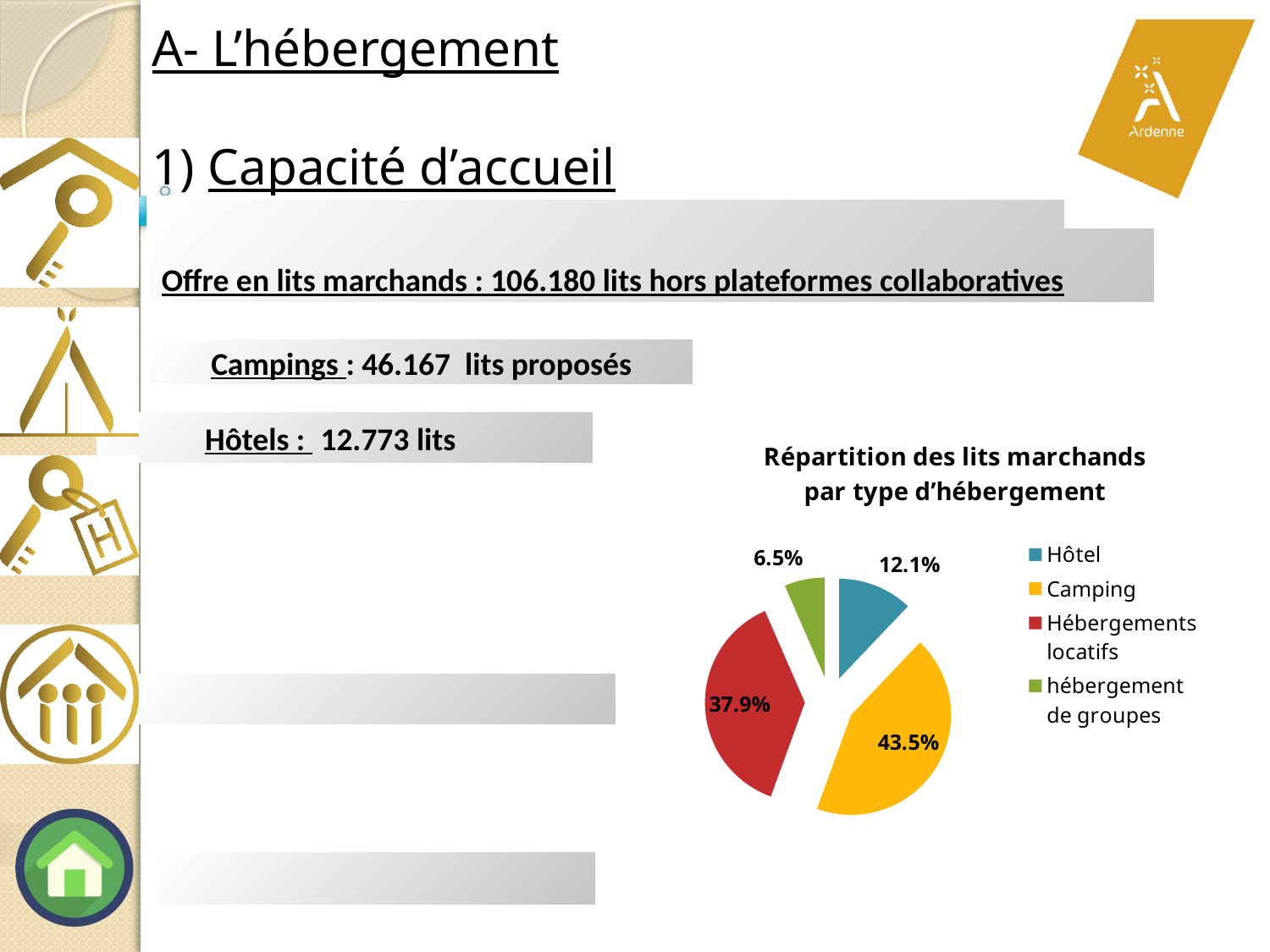
What is the title of the chart? Répartition des lits marchands par type d'hébergement What share of the pie does Hôtel represent? 12.1% What colour is the Hébergements locatifs slice? red What share of the pie does hébergement de groupes represent? 6.5% Which category has the smallest slice of the pie? hébergement de groupes How many categories does the legend list? 4 What share of the pie does Camping represent? 43.5% What type of chart is shown on the slide? pie chart What is the difference in percentage points between Camping and Hébergements locatifs? 5.6 Which category has the largest slice of the pie? Camping Which is larger, the share for Hôtel or the share for hébergement de groupes? Hôtel What share of the pie does Hébergements locatifs represent? 37.9%